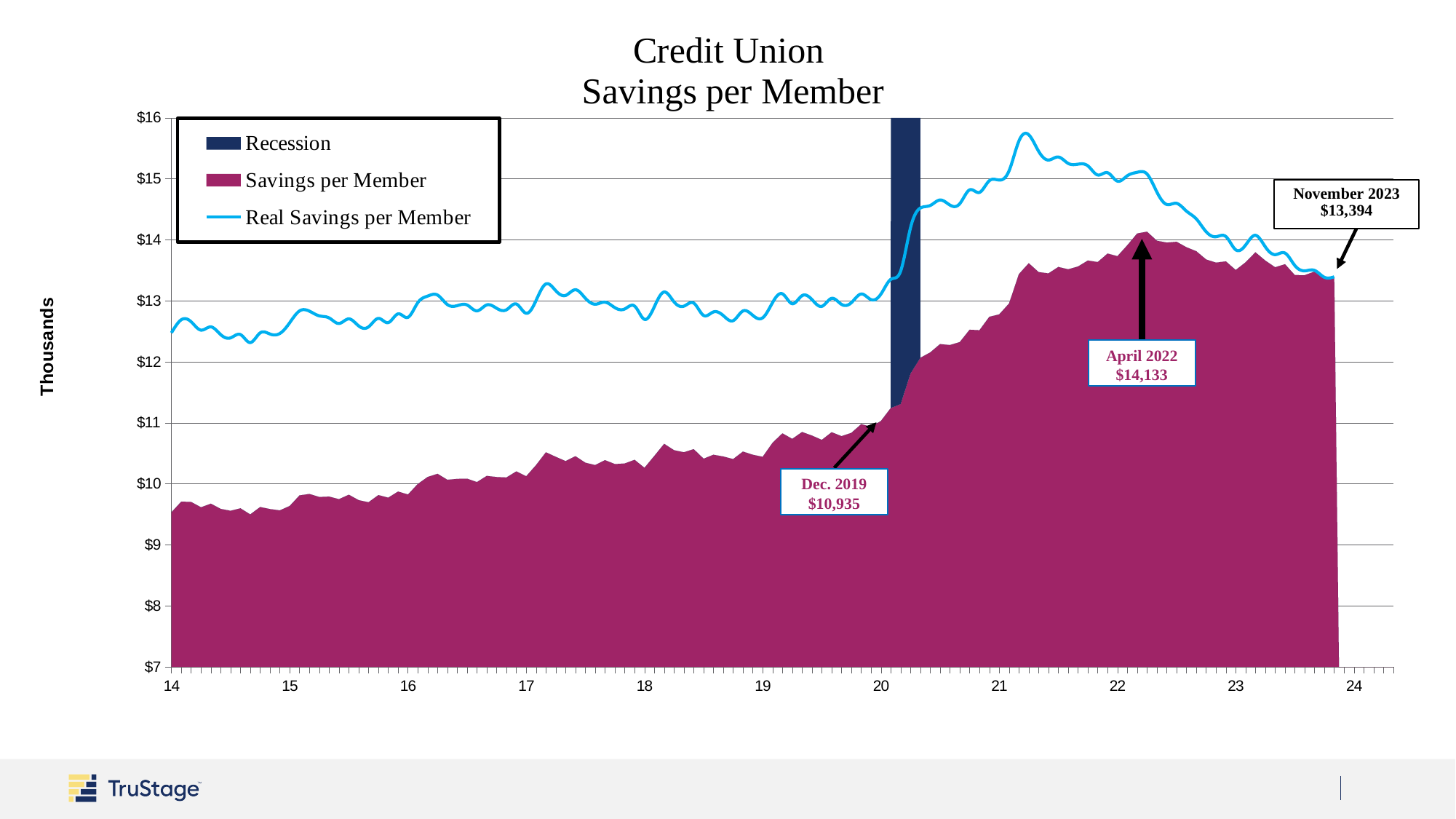
How many series does the legend list? 3 What was Savings per Member in Dec. 2019 according to the annotation? $10,935 What unit is shown on the vertical axis label? Thousands How much higher was Savings per Member in April 2022 than in Dec. 2019? $3,198 Does Real Savings per Member rise or fall between 2022 and 2023? falls Does Savings per Member rise or fall between 2014 and 2020? rises What value is labelled for April 2022? $14,133 At the start of 2014, is Savings per Member greater or less than $10 thousand? less Which is larger, the labelled value for April 2022 or for November 2023? April 2022 By how much did Savings per Member fall from April 2022 to November 2023? $739 What was Savings per Member in November 2023? $13,394 At the start of 2014, is Real Savings per Member greater or less than $12 thousand? greater